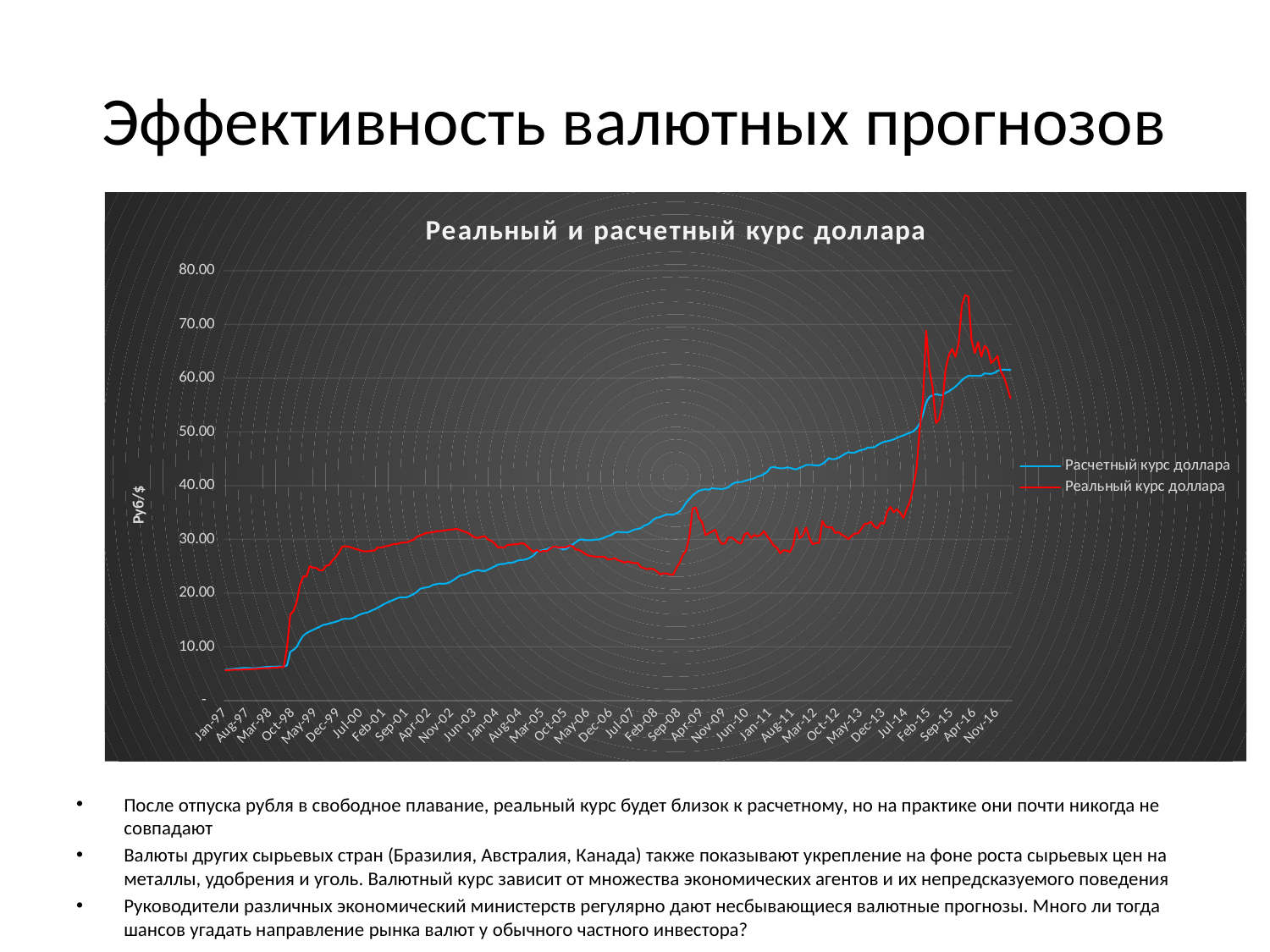
Is the value of Расчетный курс доллара at Nov-16 greater or less than 50.00? greater Is the value of Реальный курс доллара at Jan-97 greater or less than 10.00? less Is the value of Расчетный курс доллара at Jan-97 greater or less than 10.00? less Around Sep-08, which series has the higher value, Расчетный курс доллара or Реальный курс доллара? Расчетный курс доллара What colour is the line for Реальный курс доллара? red Around May-99, which series has the higher value, Расчетный курс доллара or Реальный курс доллара? Реальный курс доллара Does the Расчетный курс доллара series generally rise or fall from Jan-97 to Nov-16? rise Which series reaches the highest value anywhere on the chart? Реальный курс доллара What is the title of the chart? Реальный и расчетный курс доллара What kind of chart is shown on the slide? line chart How many series does the legend list? 2